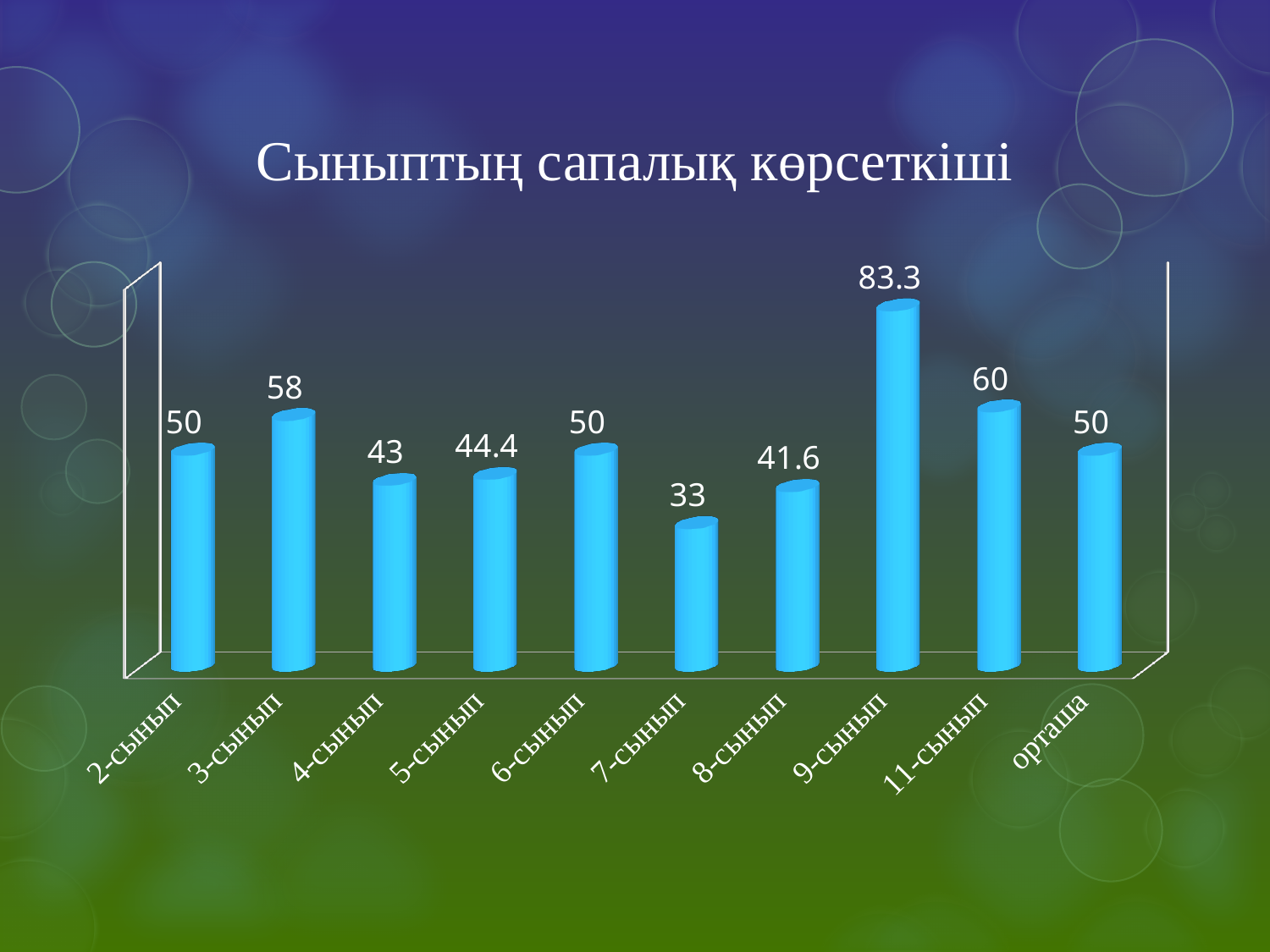
What is the value for орташа? 50 What is the title of the chart? Сыныптың сапалық көрсеткіші What is the difference between the values for 9-сынып and 7-сынып? 50.3 What kind of chart is this? bar chart Which category has the lowest value? 7-сынып What is the value for 9-сынып? 83.3 Which category has the highest value? 9-сынып How many categories are shown on the x axis? 10 Which is larger, the value for 4-сынып or the value for 5-сынып? 5-сынып What is the value for 8-сынып? 41.6 What is the difference between the values for 11-сынып and 3-сынып? 2 What is the value for 5-сынып? 44.4